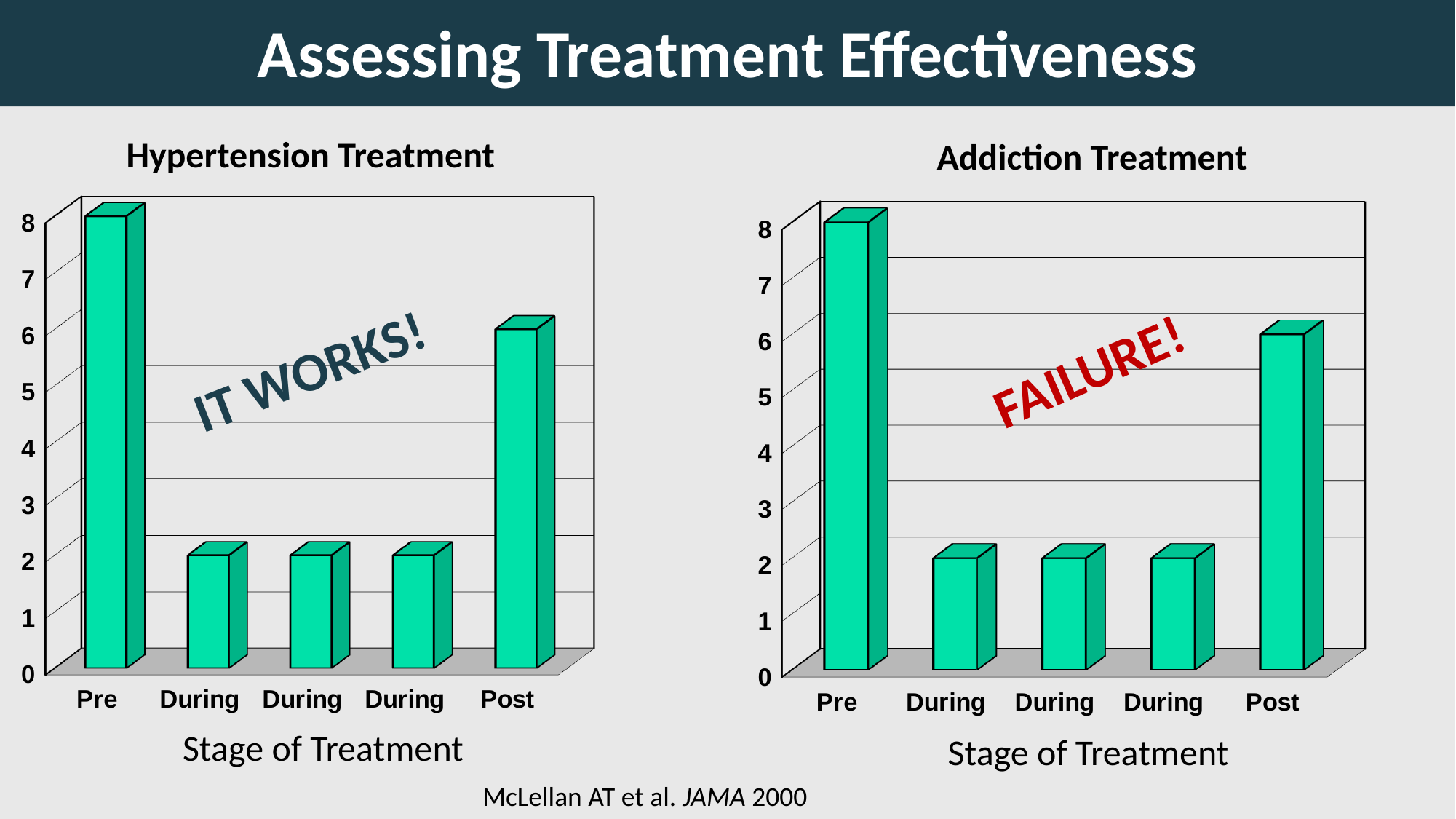
In the Hypertension Treatment chart, is the value for Post greater or less than 4? greater In the Hypertension Treatment chart, what is the value for Pre? 8 What is the x-axis title of the Hypertension Treatment chart? Stage of Treatment What text is overlaid on the Addiction Treatment chart? FAILURE! In the Addiction Treatment chart, are the During values greater or less than 4? less In the Hypertension Treatment chart, which stage has the highest value? Pre In the Addiction Treatment chart, what is the difference between the Pre value and the Post value? 2 In the Hypertension Treatment chart, which is larger, the value for Pre or the value for Post? Pre In the Addiction Treatment chart, which stage has the highest value? Pre What kind of chart is the Addiction Treatment chart? Bar chart How many bars are shown in the Hypertension Treatment chart? 5 In the Addiction Treatment chart, what is the value for Post? 6